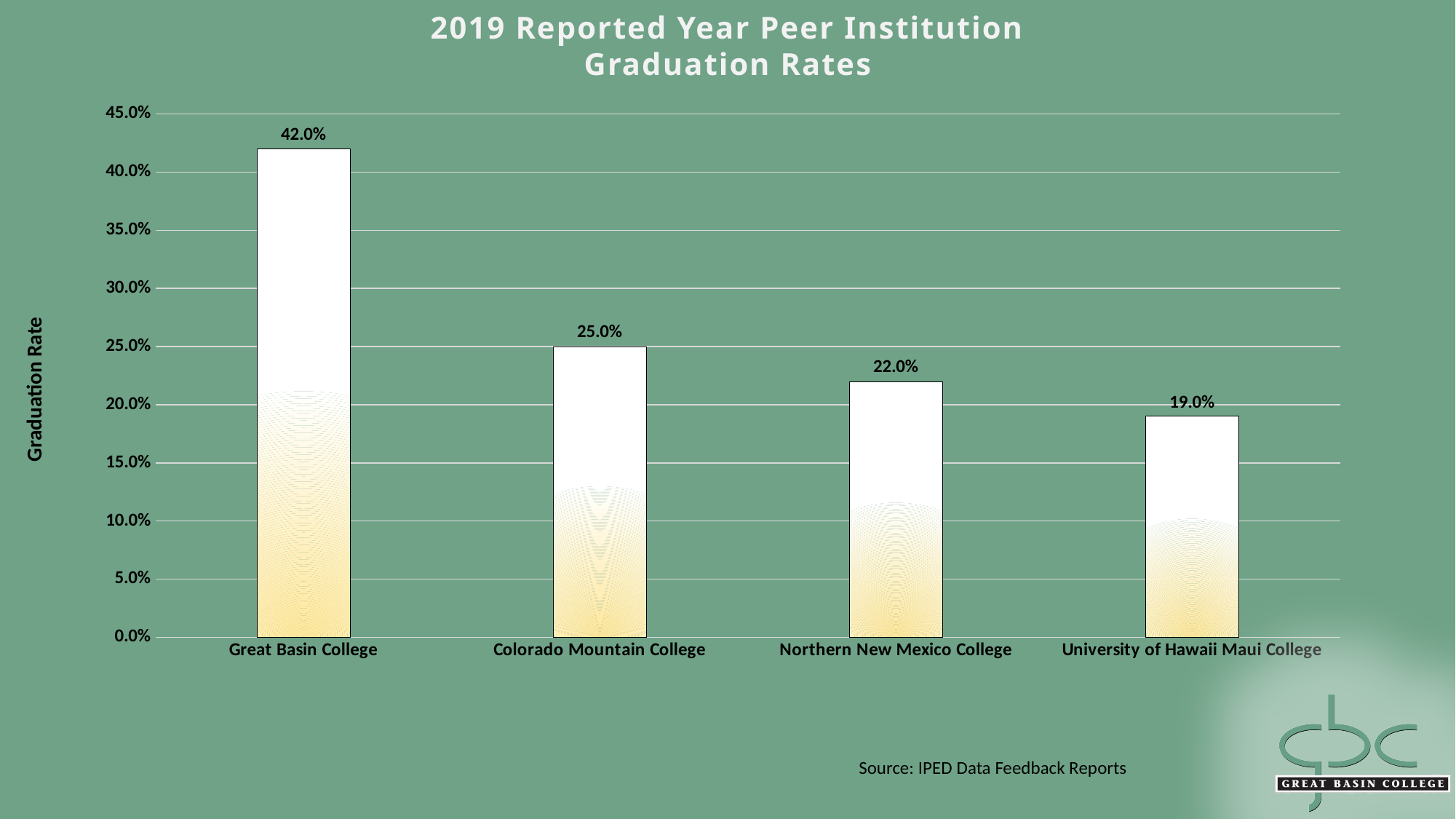
What is the graduation rate for University of Hawaii Maui College? 19.0% What is the title of the chart? 2019 Reported Year Peer Institution Graduation Rates What is the difference between the graduation rates of Great Basin College and Colorado Mountain College? 17.0% Which has a higher graduation rate, Northern New Mexico College or University of Hawaii Maui College? Northern New Mexico College What is the graduation rate for Colorado Mountain College? 25.0% What is the graduation rate for Northern New Mexico College? 22.0% Which institution has the highest graduation rate? Great Basin College Do the graduation rates rise or fall from left to right across the chart? Fall What kind of chart is shown on the slide? Bar chart Which institution has the lowest graduation rate? University of Hawaii Maui College What is the graduation rate for Great Basin College? 42.0% How many institutions are shown in the chart? 4